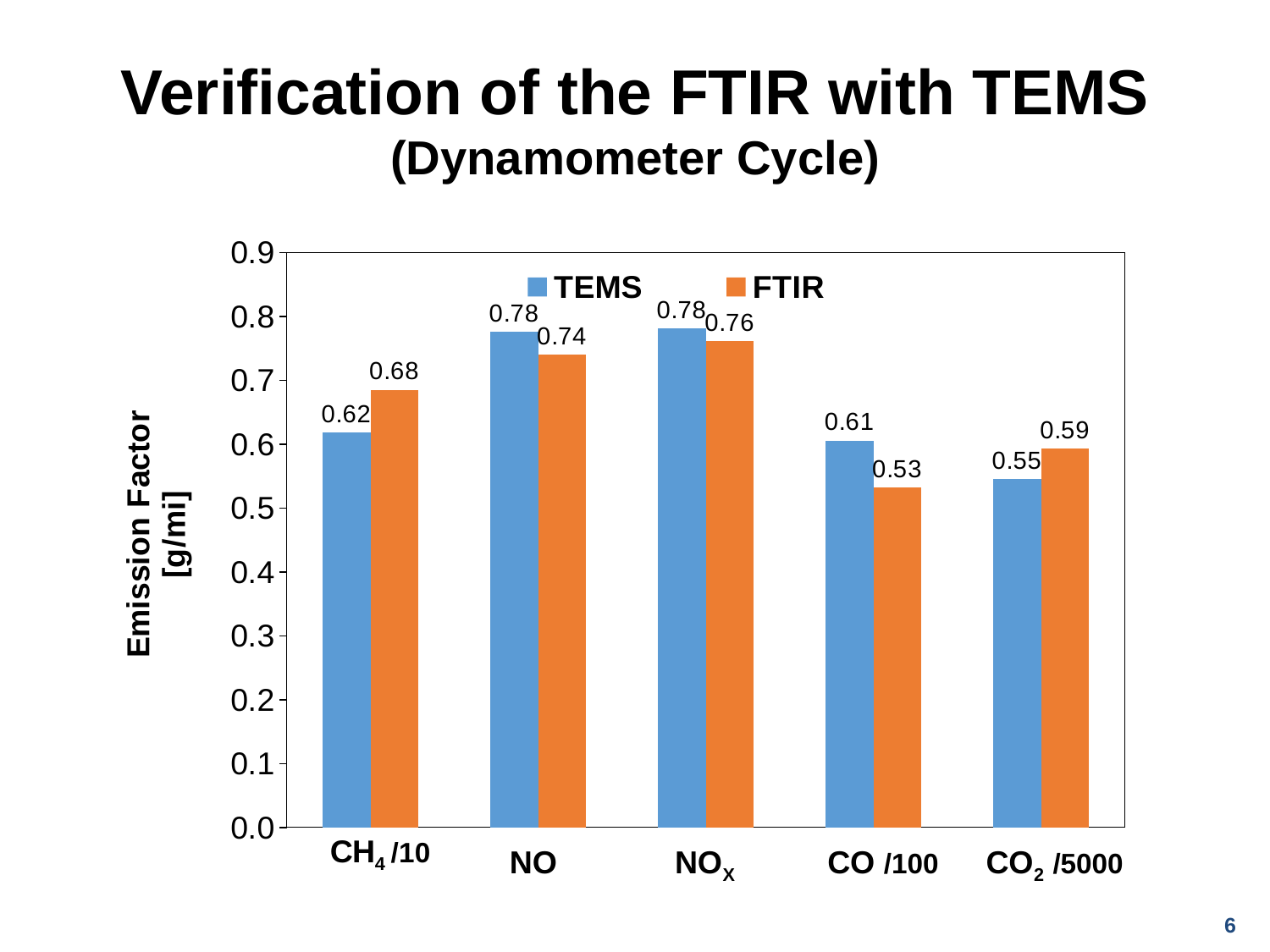
Which category has the lowest TEMS value? CO2 /5000 For CO2 /5000, which is larger, the TEMS value or the FTIR value? FTIR What is the difference between the TEMS and FTIR values for CO /100? 0.08 What is the TEMS value for NO? 0.78 Which category has the lowest FTIR value? CO /100 How many series does the legend list? 2 What is the FTIR value for CH4 /10? 0.68 Which category has the highest FTIR value? NOx What is the difference between the FTIR and TEMS values for CH4 /10? 0.06 What is the FTIR value for CO /100? 0.53 Is the TEMS value for NOx greater or less than 0.7? greater How many categories are shown on the x axis? 5